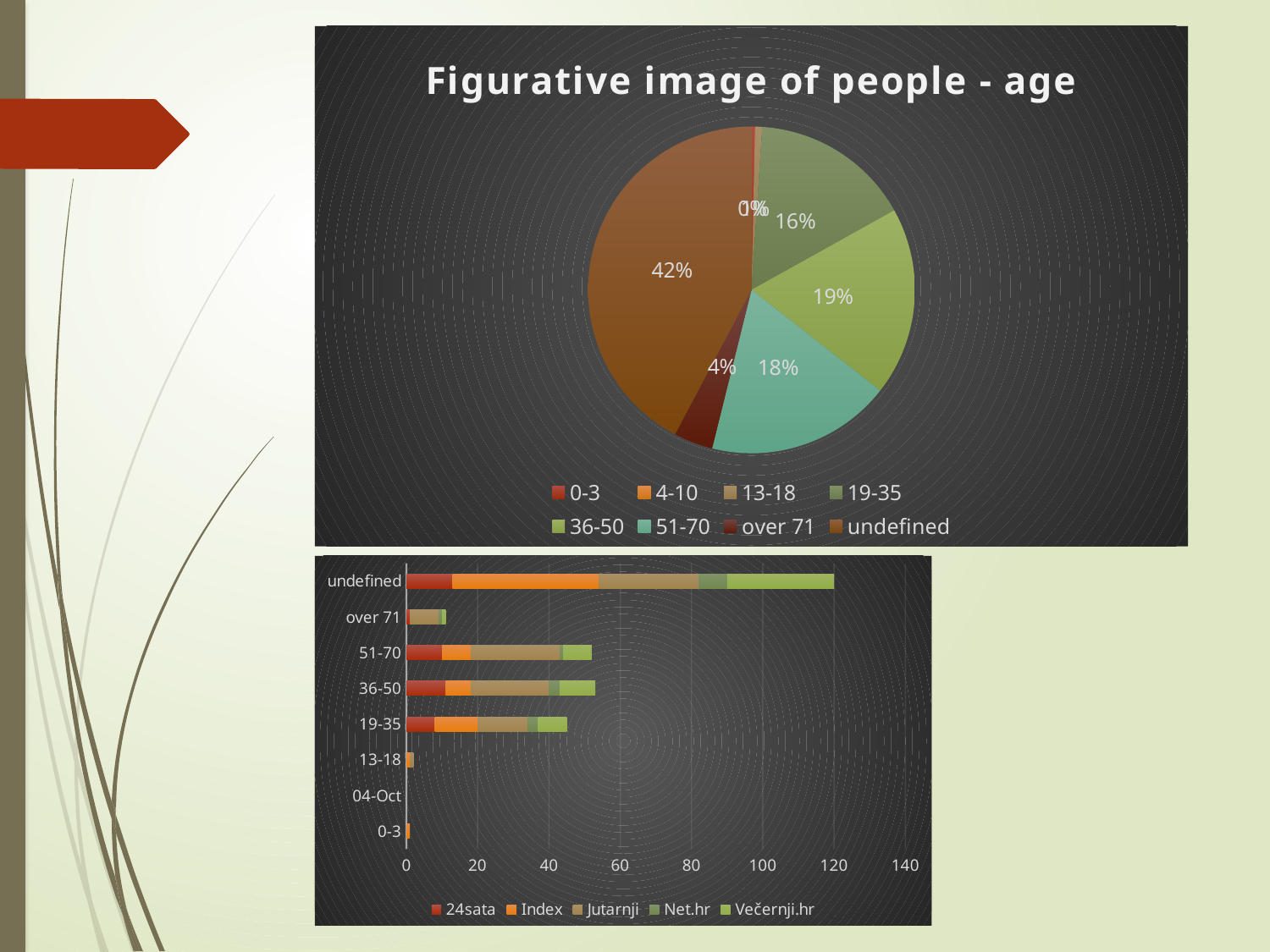
In the lower bar chart, which category has the longest stacked bar? undefined In the pie chart titled 'Figurative image of people - age', what percentage is shown for the '51-70' slice? 18% In the pie chart titled 'Figurative image of people - age', what percentage is shown for the '36-50' slice? 19% In the pie chart titled 'Figurative image of people - age', how many categories does the legend list? 8 In the pie chart titled 'Figurative image of people - age', which slice is larger, '36-50' or '51-70'? 36-50 In the lower bar chart, is the total length of the 'undefined' bar greater or less than 100? greater In the pie chart titled 'Figurative image of people - age', what percentage is shown for the 'over 71' slice? 4% What kind of chart is the lower chart on the slide? bar chart In the lower bar chart, how many series does the legend list? 5 In the pie chart titled 'Figurative image of people - age', what percentage is shown for the 'undefined' slice? 42% What kind of chart is the upper chart titled 'Figurative image of people - age'? pie chart In the pie chart titled 'Figurative image of people - age', which category has the largest slice? undefined